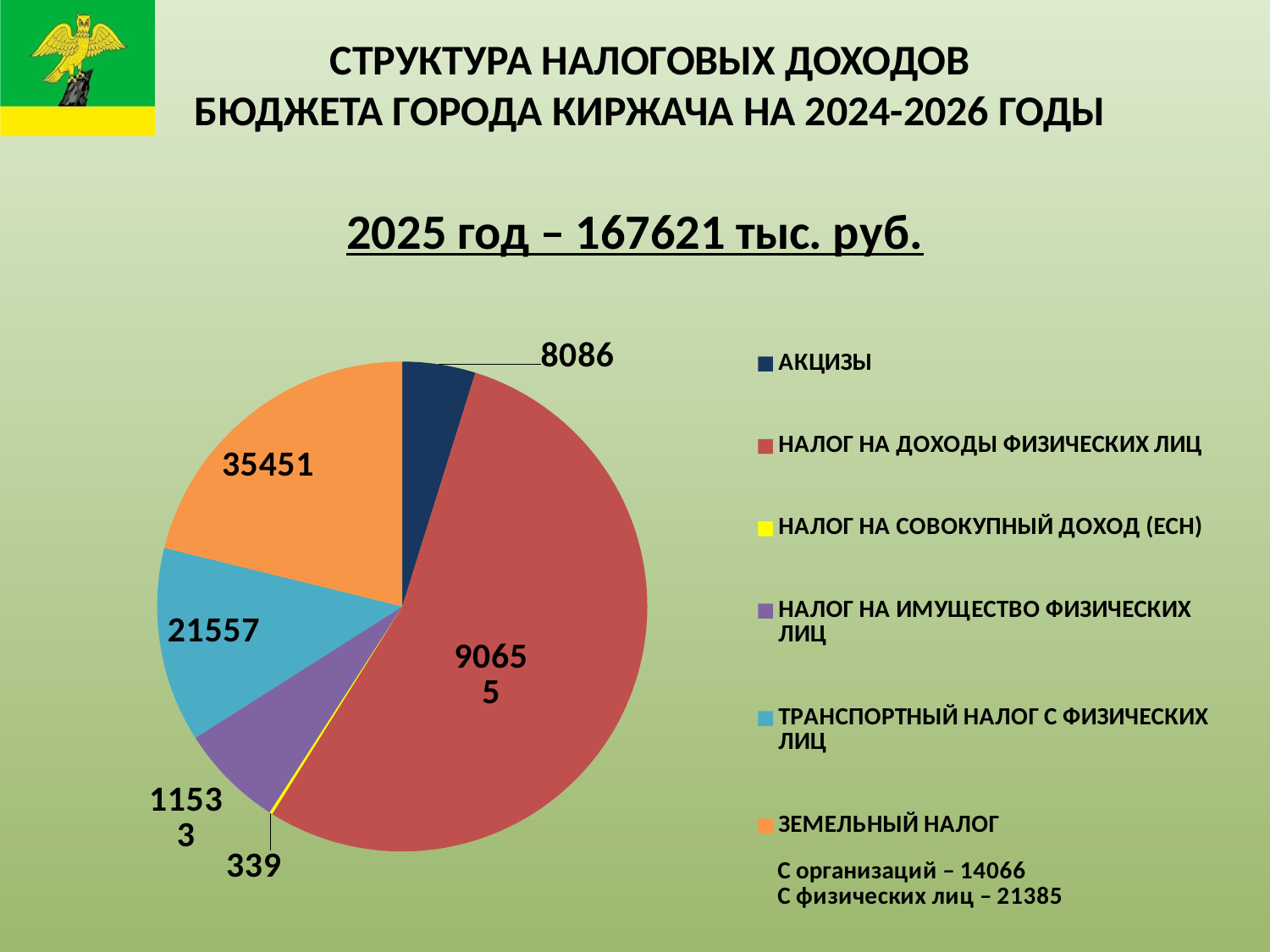
What value is shown for АКЦИЗЫ in the pie chart? 8086 What value is shown for ТРАНСПОРТНЫЙ НАЛОГ С ФИЗИЧЕСКИХ ЛИЦ in the pie chart? 21557 Which category has the largest slice in the pie chart? НАЛОГ НА ДОХОДЫ ФИЗИЧЕСКИХ ЛИЦ What total amount for 2025 is stated in the heading above the pie chart? 167621 тыс. руб. Which is larger: the value for НАЛОГ НА ИМУЩЕСТВО ФИЗИЧЕСКИХ ЛИЦ or the value for АКЦИЗЫ? НАЛОГ НА ИМУЩЕСТВО ФИЗИЧЕСКИХ ЛИЦ Which category has the smallest slice in the pie chart? НАЛОГ НА СОВОКУПНЫЙ ДОХОД (ЕСН) What value is shown for НАЛОГ НА ДОХОДЫ ФИЗИЧЕСКИХ ЛИЦ in the pie chart? 90655 How many categories does the pie chart show? 6 What kind of chart is shown on the slide? pie chart What is the difference between the values for ЗЕМЕЛЬНЫЙ НАЛОГ and ТРАНСПОРТНЫЙ НАЛОГ С ФИЗИЧЕСКИХ ЛИЦ? 13894 What value is shown for ЗЕМЕЛЬНЫЙ НАЛОГ in the pie chart? 35451 What colour is the slice for ЗЕМЕЛЬНЫЙ НАЛОГ in the pie chart? orange